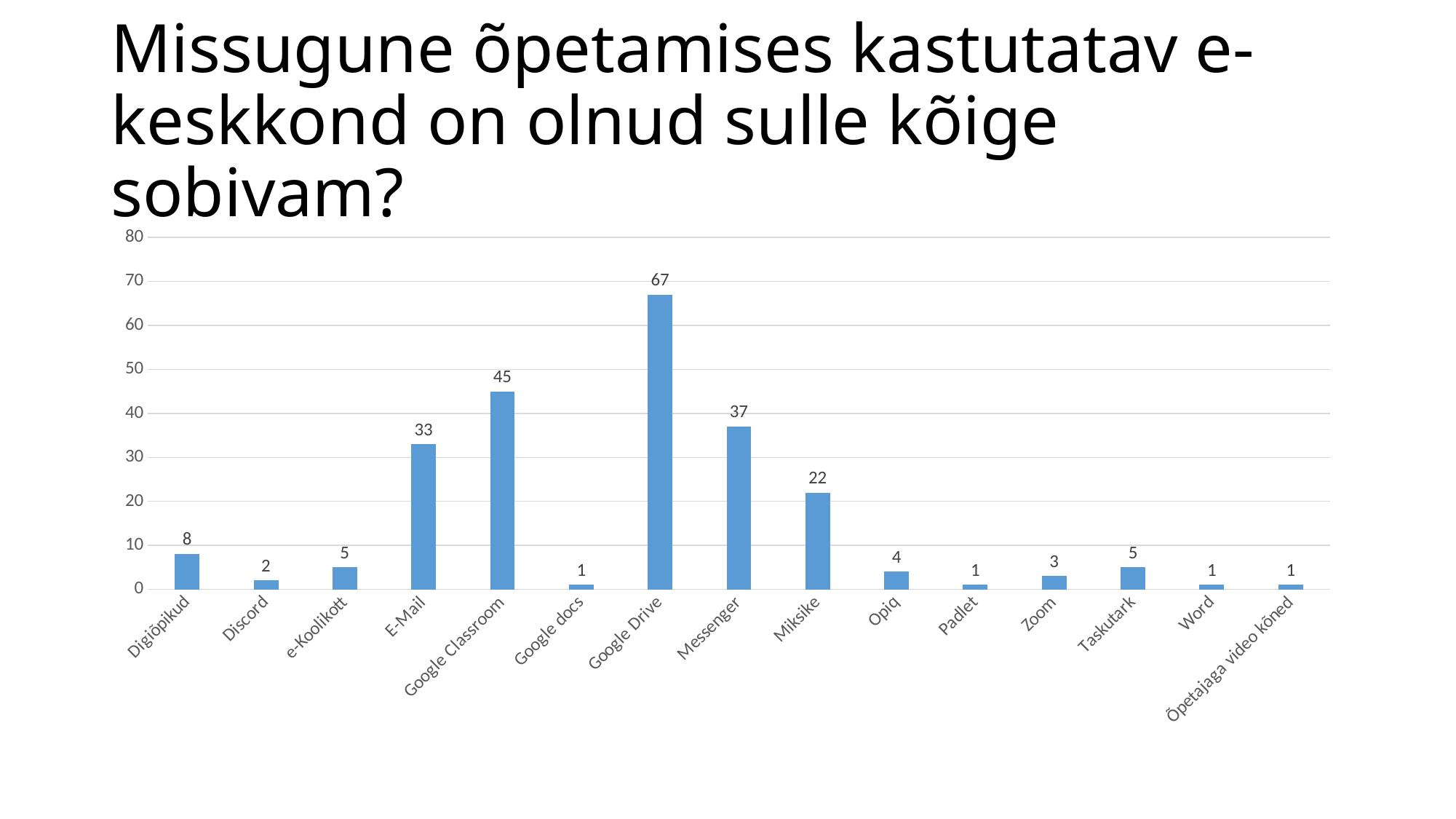
What value is shown for Google Drive? 67 What kind of chart is shown on the slide? Bar chart How many categories are shown on the x axis? 15 What value is shown for Digiõpikud? 8 What value is shown for Messenger? 37 What value is shown for Miksike? 22 What is the highest value shown on the vertical axis? 80 Which has a larger value, Google Classroom or Messenger? Google Classroom Which category has the highest value? Google Drive What is the difference between the values for E-Mail and Miksike? 11 What is the difference between the values for Google Drive and Google Classroom? 22 Which has a larger value, Opiq or Zoom? Opiq